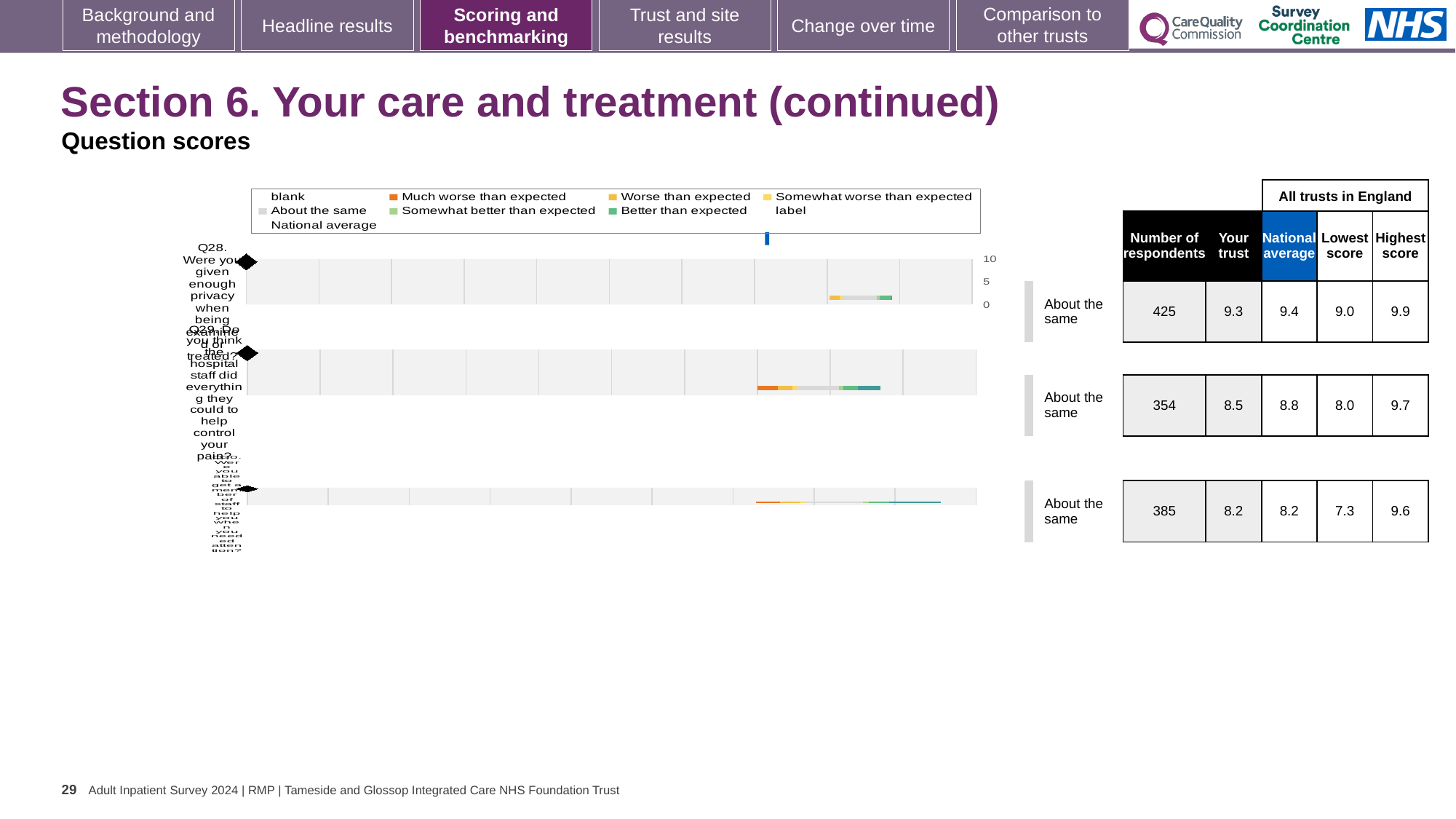
What is the 'Your trust' score for Q28 (privacy when being examined or treated)? 9.3 How many questions (Q28, Q29, Q30) are plotted in the chart? 3 For Q28, which is larger: the 'Your trust' score or the national average? National average Which question has the largest number of respondents? Q28 What is the lowest score among all trusts in England for Q30? 7.3 Which question has the lowest 'Your trust' score? Q30 What benchmark category is shown for Q29? About the same What is the national average score for Q29 (staff did everything to help control your pain)? 8.8 What kind of chart is used to show the question scores on this slide? bar chart What is the difference between the highest and lowest scores for Q29? 1.7 What is the highest score among all trusts in England for Q28? 9.9 How many respondents answered Q30 (able to get a member of staff to help when needed)? 385